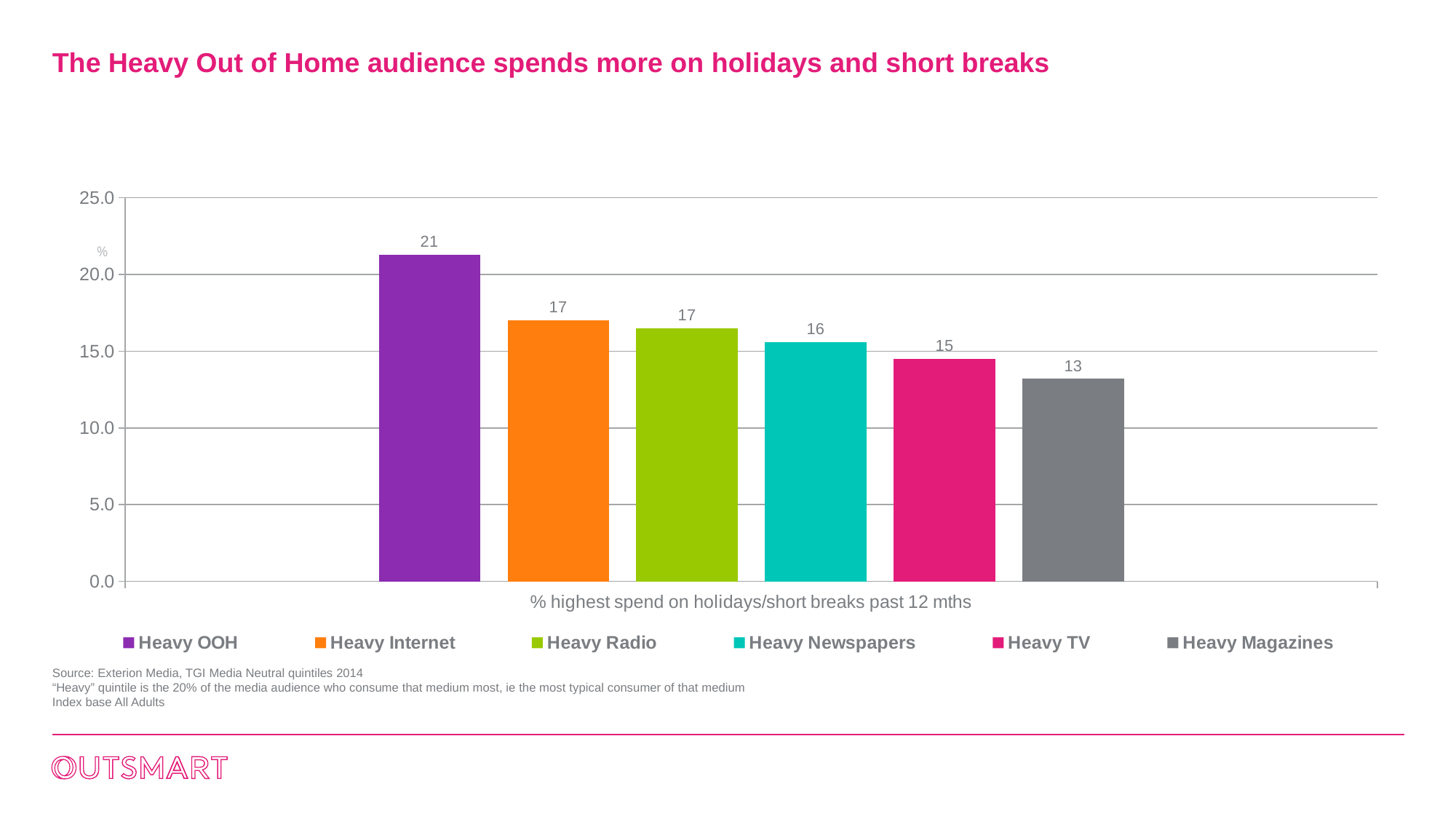
Which is larger, the value for Heavy Newspapers or the value for Heavy Magazines? Heavy Newspapers What is the difference between the values for Heavy OOH and Heavy Magazines? 8 What is the value for Heavy Magazines? 13 What is the difference between the values for Heavy OOH and Heavy TV? 6 Is the value for Heavy OOH greater or less than 20.0? greater What kind of chart is shown on the slide? Bar chart Which series has the highest value? Heavy OOH What is the value for Heavy TV? 15 What is the value for Heavy OOH? 21 Which series has the lowest value? Heavy Magazines What is the value for Heavy Newspapers? 16 How many series does the legend list? 6